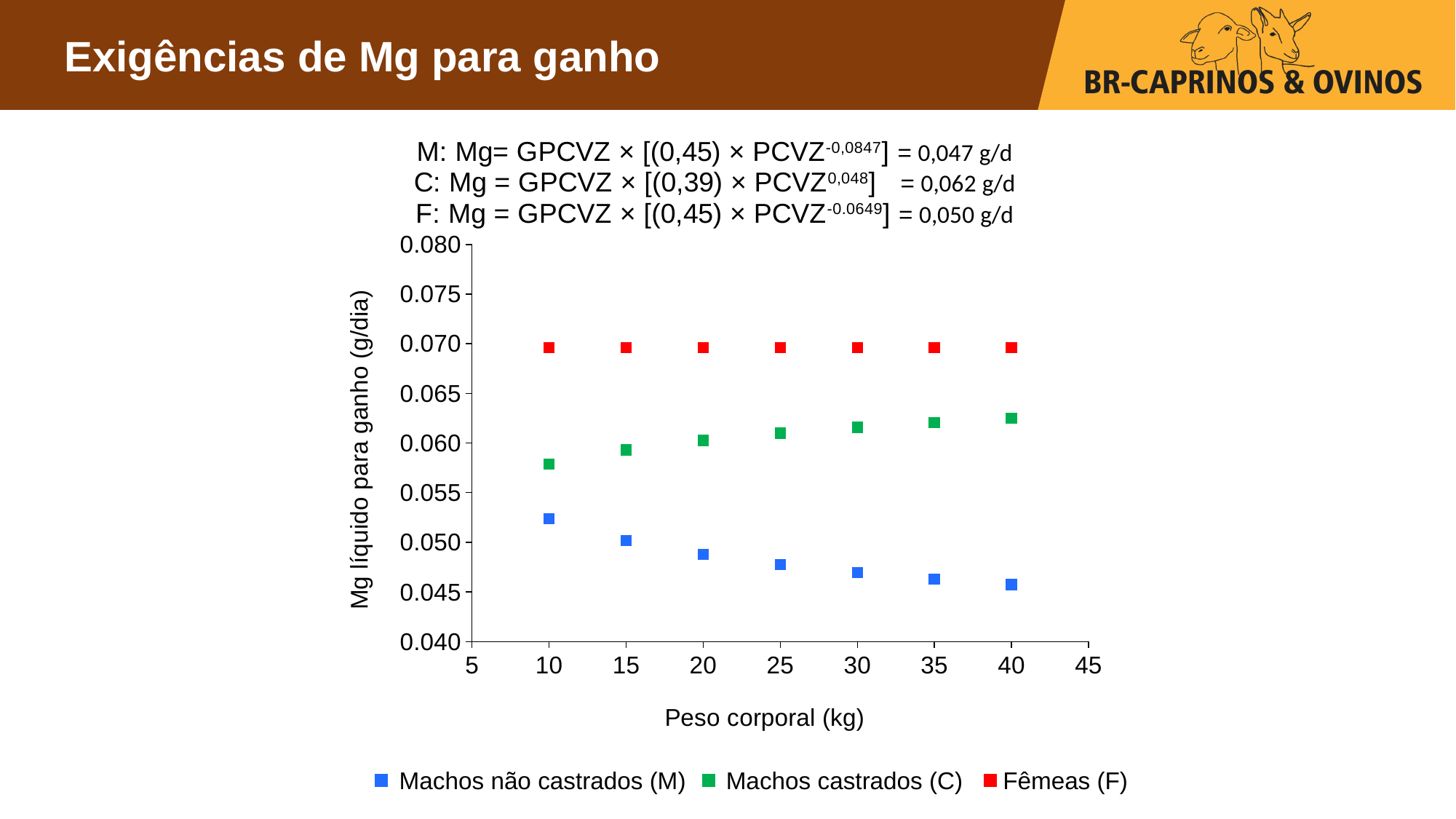
What kind of chart is shown on the slide? Scatter chart How many body weight points are plotted for the Fêmeas (F) series? 7 Is the value for Fêmeas (F) at 20 kg greater or less than 0.065? greater At 10 kg body weight, which is larger: the value for Machos castrados (C) or for Machos não castrados (M)? Machos castrados (C) What is the title of the x axis? Peso corporal (kg) How many series does the legend list? 3 Is the value for Machos castrados (C) at 40 kg greater or less than 0.060? greater Which series has the lowest Mg líquido para ganho at 40 kg body weight? Machos não castrados (M) Which series has the highest Mg líquido para ganho at 25 kg body weight? Fêmeas (F) Do the values for Machos castrados (C) rise or fall as body weight increases from 10 to 40 kg? Rise Do the values for Machos não castrados (M) rise or fall as body weight increases from 10 to 40 kg? Fall Is the value for Machos não castrados (M) at 40 kg greater or less than 0.050? less